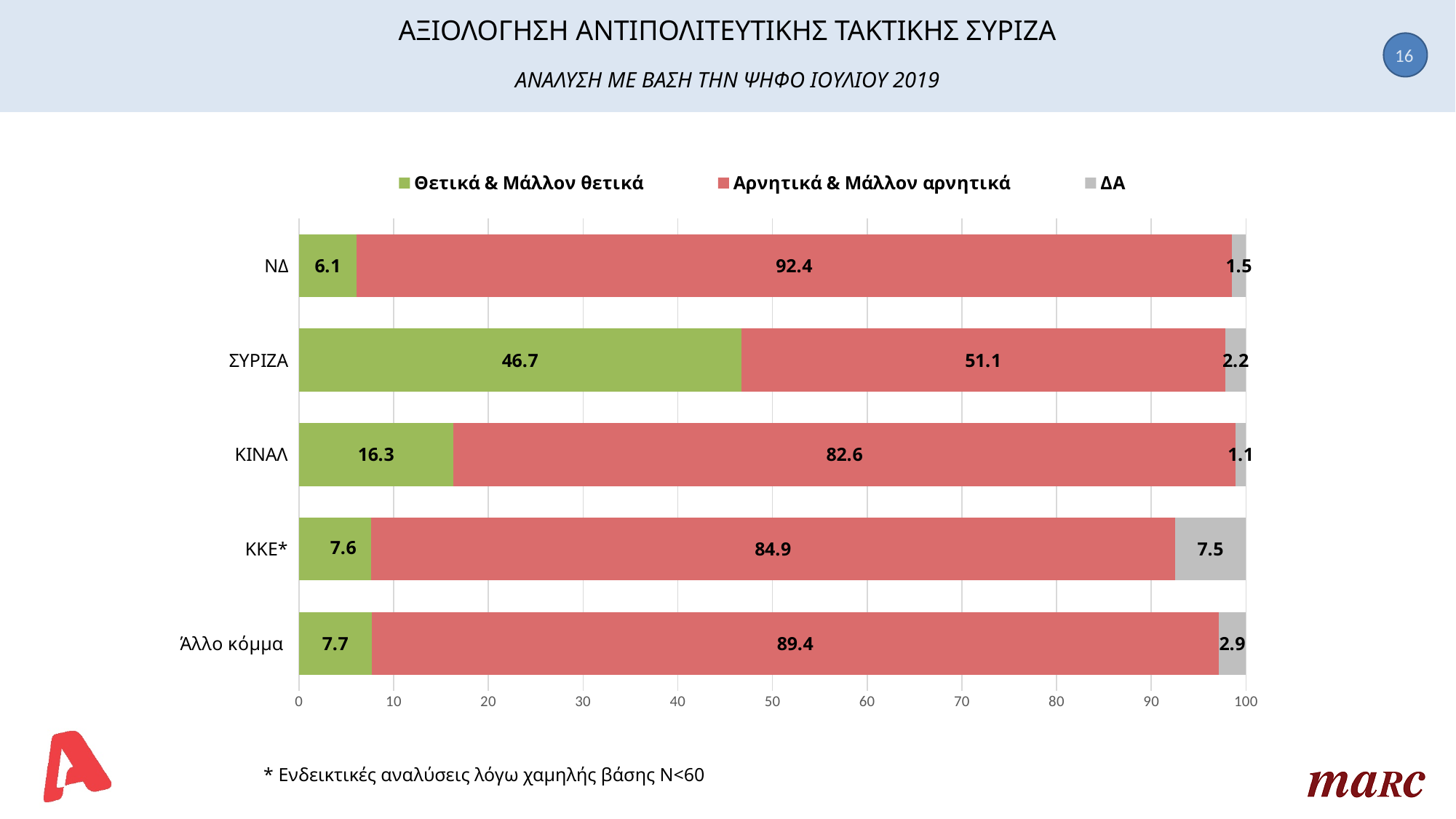
What is the value of Αρνητικά & Μάλλον αρνητικά for ΝΔ? 92.4 Is the Αρνητικά & Μάλλον αρνητικά value for ΚΚΕ* greater or less than 80? greater What type of chart is shown on the slide? Stacked bar chart Which category has the lowest Αρνητικά & Μάλλον αρνητικά value? ΣΥΡΙΖΑ Which category has the highest Θετικά & Μάλλον θετικά value? ΣΥΡΙΖΑ What is the difference between the Αρνητικά & Μάλλον αρνητικά and Θετικά & Μάλλον θετικά values for ΣΥΡΙΖΑ? 4.4 How many series does the legend list? 3 What is the ΔΑ value for ΚΚΕ*? 7.5 Which category has the lowest ΔΑ value? ΚΙΝΑΛ What is the value of Θετικά & Μάλλον θετικά for ΣΥΡΙΖΑ? 46.7 Which is larger: the Θετικά & Μάλλον θετικά value for ΚΙΝΑΛ or for ΝΔ? ΚΙΝΑΛ How many categories are shown on the chart? 5